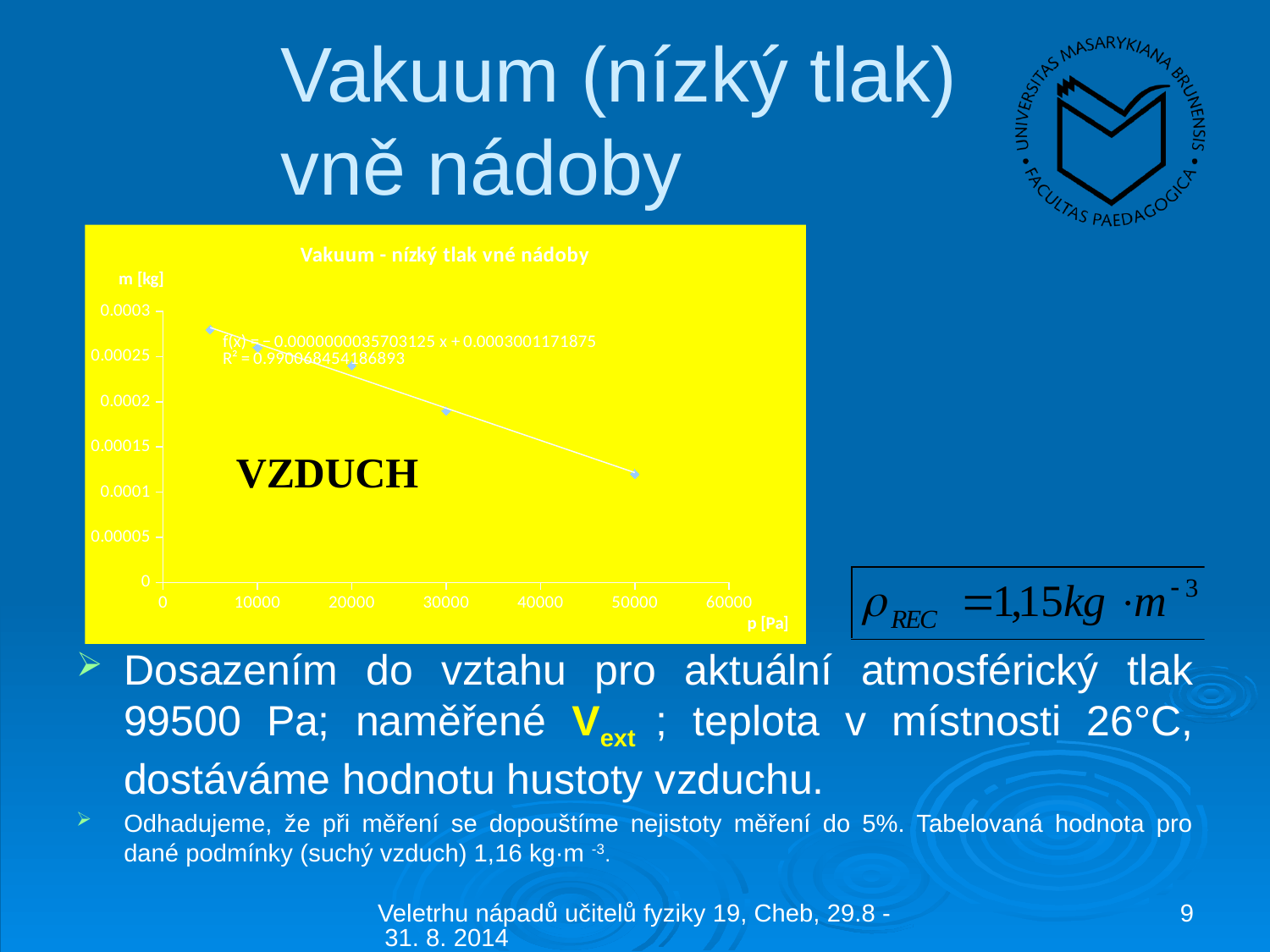
Is the mass value of the leftmost data point greater or less than 0.00025 kg? greater What kind of chart is shown on the slide? scatter chart with a trendline What is the title of the chart? Vakuum - nízký tlak vné nádoby What quantity and unit are shown on the x axis of the chart? p [Pa] Is the mass value of the rightmost data point (near 50000 Pa) greater or less than 0.0001 kg? greater Which data point has the larger mass: the leftmost point or the rightmost point? the leftmost point What is the slope of the fitted trendline f(x) shown in the chart? -0.0000000035703125 As pressure p increases along the x axis, does the mass m rise or fall? fall Is the mass value of the data point near 30000 Pa greater or less than 0.0002 kg? less What is the intercept of the fitted trendline f(x) shown in the chart? 0.0003001171875 How many data points are plotted in the chart? 5